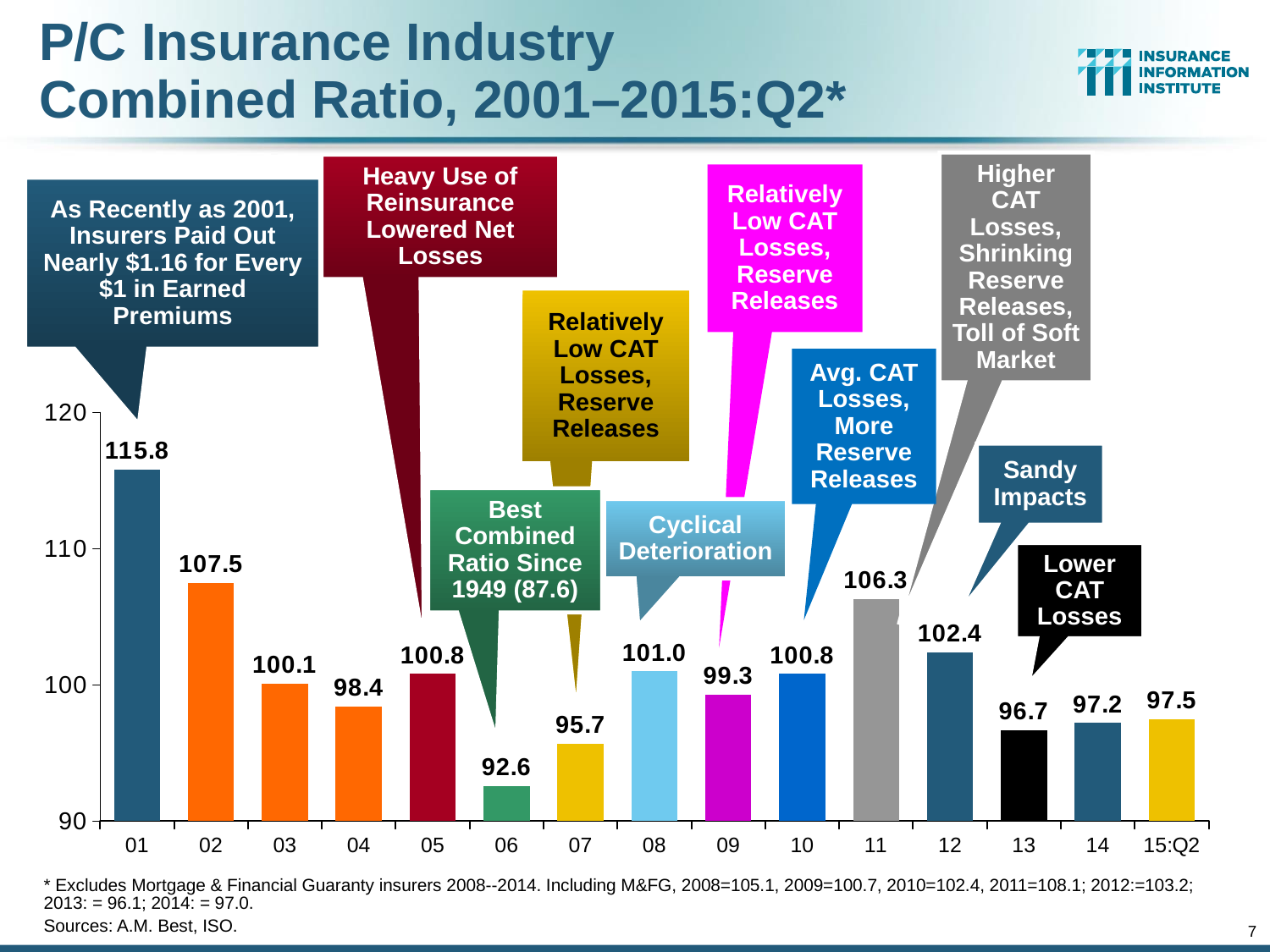
How many bars are plotted in the chart? 15 What is the combined ratio shown for 2011 (11)? 106.3 What is the combined ratio for 2001 (01)? 115.8 Is the combined ratio for 13 greater or less than 100? less Do the combined ratio values rise or fall from 01 to 04? Fall Which year has the lowest combined ratio? 06 What is the difference between the combined ratio in 01 and in 06? 23.2 Which year has the larger combined ratio, 08 or 09? 08 Which year has the highest combined ratio? 01 What kind of chart is shown on the slide? Bar chart What is the combined ratio shown for 15:Q2? 97.5 What is the difference between the combined ratio in 11 and in 12? 3.9